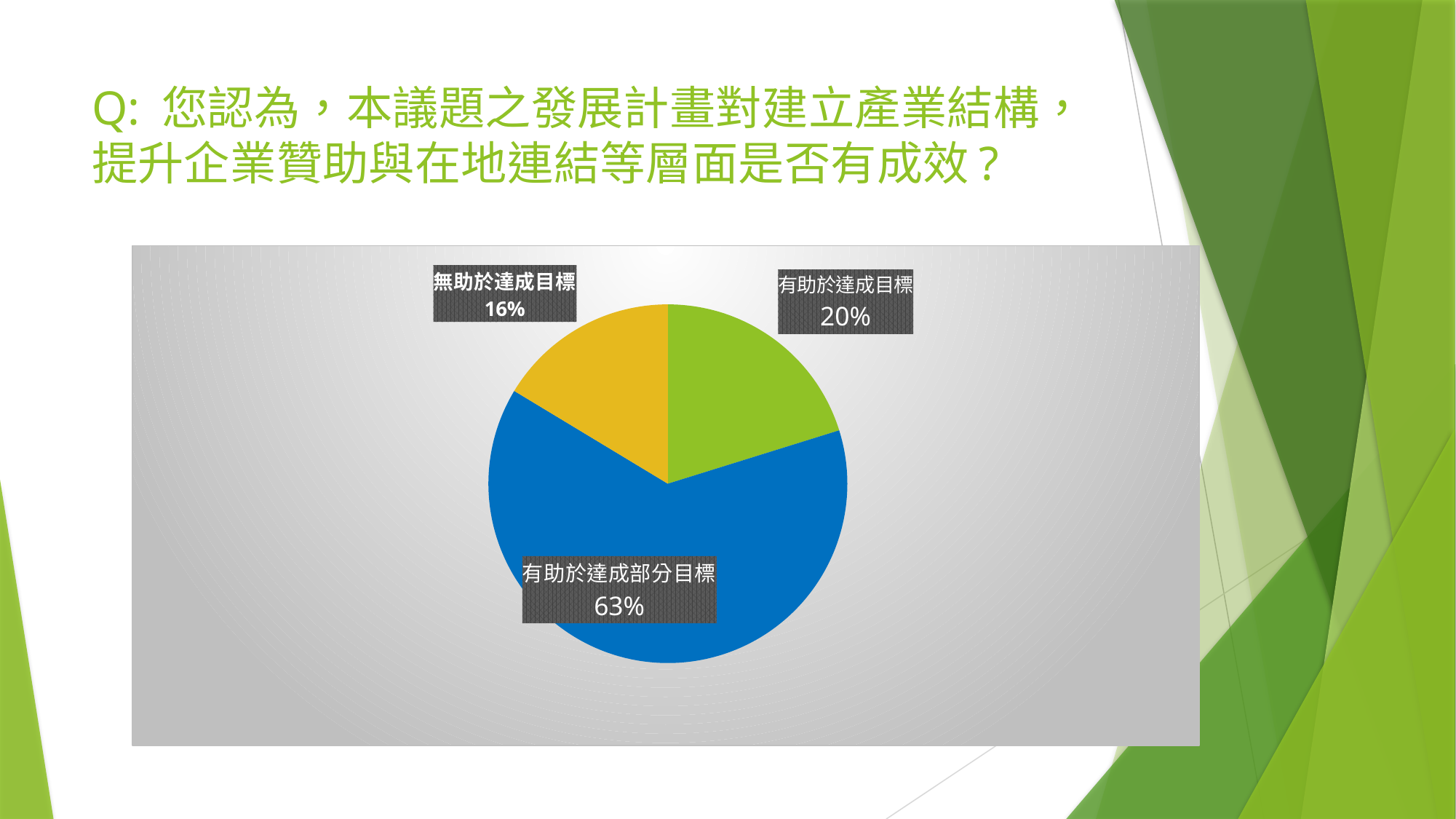
What is the difference in percentage points between 有助於達成部分目標 and 有助於達成目標? 43 Which category has the smallest slice of the pie? 無助於達成目標 How many categories are shown in the pie chart? 3 Which is larger, the share for 有助於達成目標 or the share for 無助於達成目標? 有助於達成目標 What colour is the slice for 無助於達成目標? yellow Which category has the largest slice of the pie? 有助於達成部分目標 What share of the pie does 無助於達成目標 represent? 16% What is the difference in percentage points between 有助於達成目標 and 無助於達成目標? 4 What share of the pie does 有助於達成部分目標 represent? 63% What share of the pie does 有助於達成目標 represent? 20% What colour is the slice for 有助於達成部分目標? blue What kind of chart is shown on the slide? pie chart